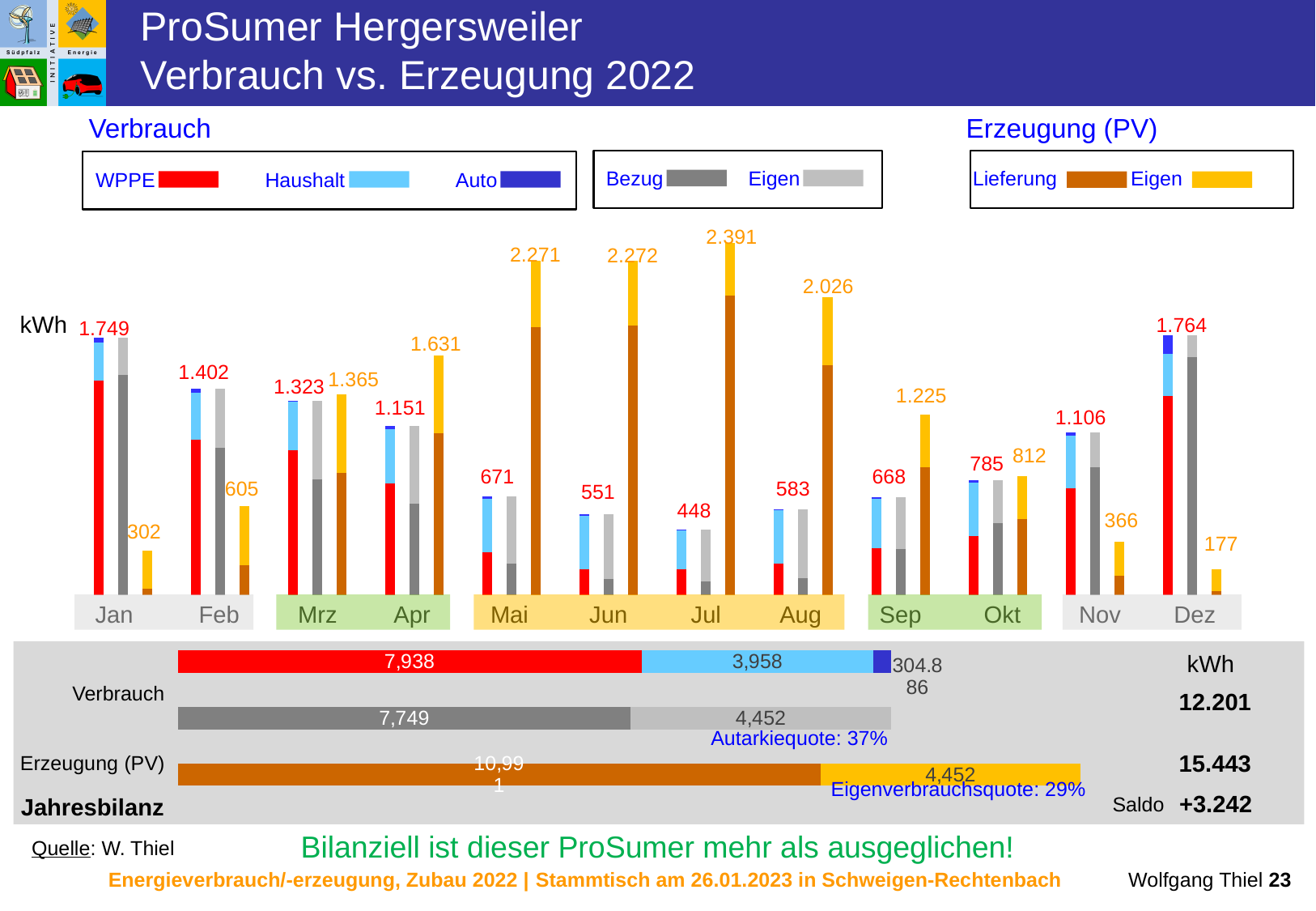
In the monthly chart, which month has the lowest consumption value? Jul How many months are shown on the x axis of the monthly chart? 12 In the monthly chart, what is the PV generation (Erzeugung) value shown for Jul? 2.391 In the Jahresbilanz chart at the bottom, what is the total Erzeugung (PV) value in kWh? 15.443 In the monthly chart, what is the consumption (Verbrauch) value shown for Jan? 1.749 What kind of chart is the monthly Verbrauch vs. Erzeugung chart? Bar chart In the monthly chart, what is the difference between the PV generation and the consumption in Jul? 1.943 In the monthly chart, which month has the lowest PV generation value? Dez How many series does the Verbrauch legend (WPPE, Haushalt, Auto) list? 3 In the monthly chart, does the consumption value rise or fall from Jan to Jul? Fall In the monthly chart, which month has the highest PV generation value? Jul In the monthly chart, which is larger in Feb: the consumption value or the PV generation value? Consumption (1.402)